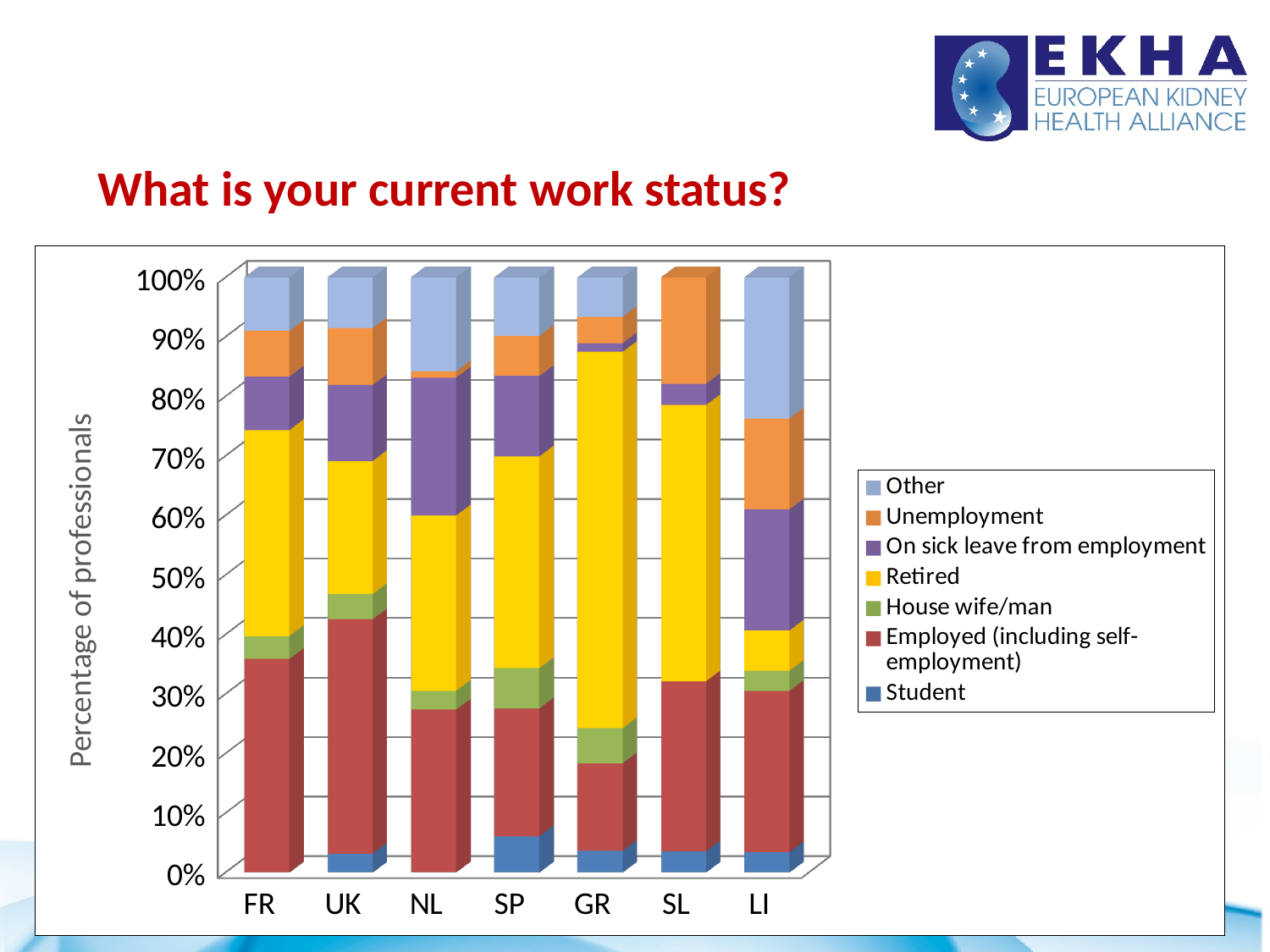
What kind of chart is shown on the slide? stacked bar chart How many countries are shown on the x axis of the chart? 7 Which country has the largest Employed (including self-employment) share? UK Is the Employed (including self-employment) share for FR greater or less than 30%? greater How many series does the chart's legend list? 7 Which country has the largest Retired share? GR What is the title of the chart? What is your current work status? Is the Retired share for GR greater or less than 50%? greater What is the label on the vertical axis of the chart? Percentage of professionals Which country has the largest Unemployment share? SL Is the Retired share for GR larger or smaller than the Retired share for FR? larger